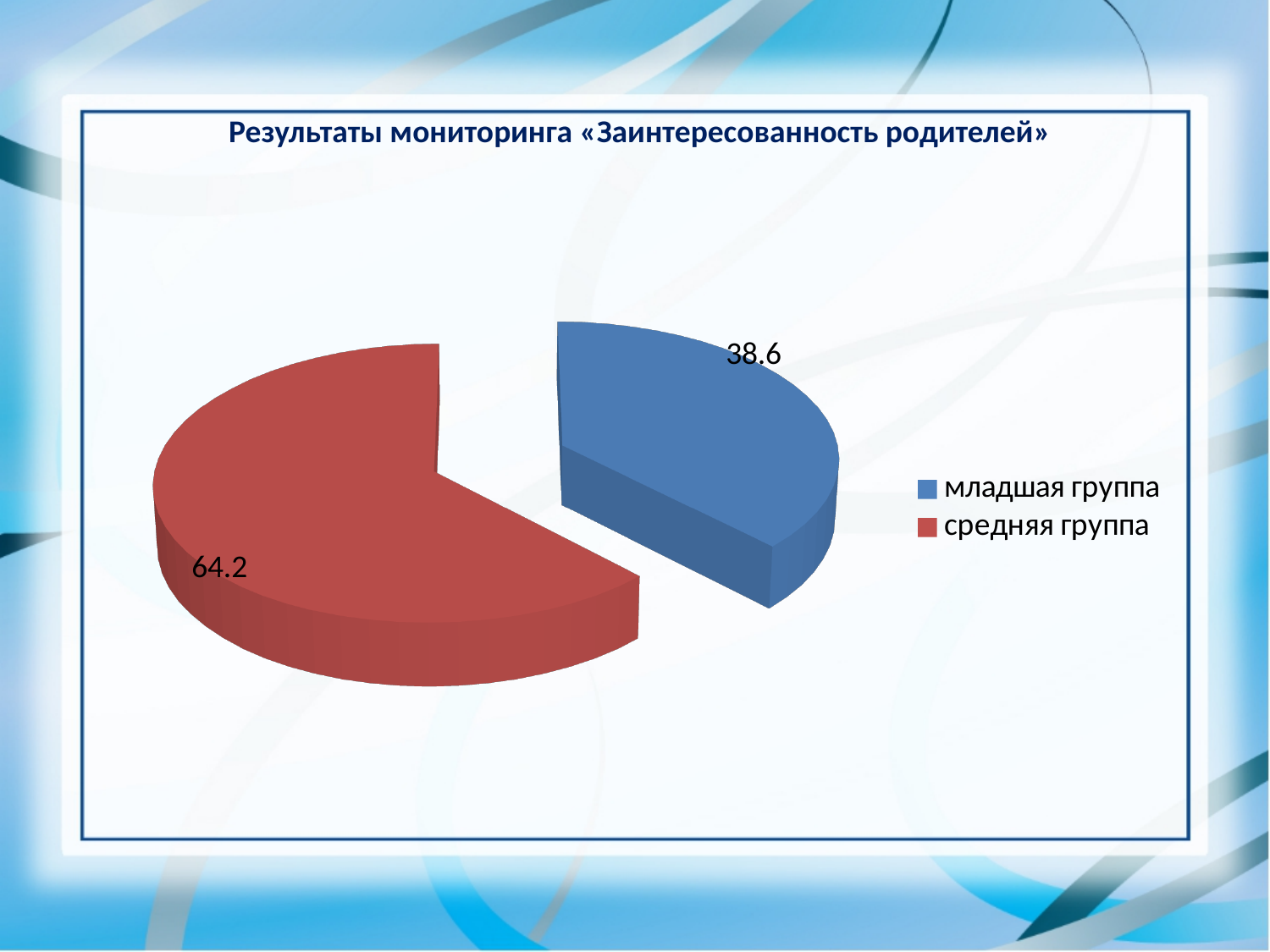
What kind of chart is shown on the slide? pie chart Which is larger, the value for младшая группа or the value for средняя группа? средняя группа What colour is the slice for средняя группа? red How many slices does the pie chart have? 2 What value is shown for младшая группа? 38.6 Which group has the smallest slice of the pie? младшая группа How many entries does the legend list? 2 Which group has the largest slice of the pie? средняя группа What value is shown for средняя группа? 64.2 What is the title of the chart? Результаты мониторинга «Заинтересованность родителей» What is the difference between the values for средняя группа and младшая группа? 25.6